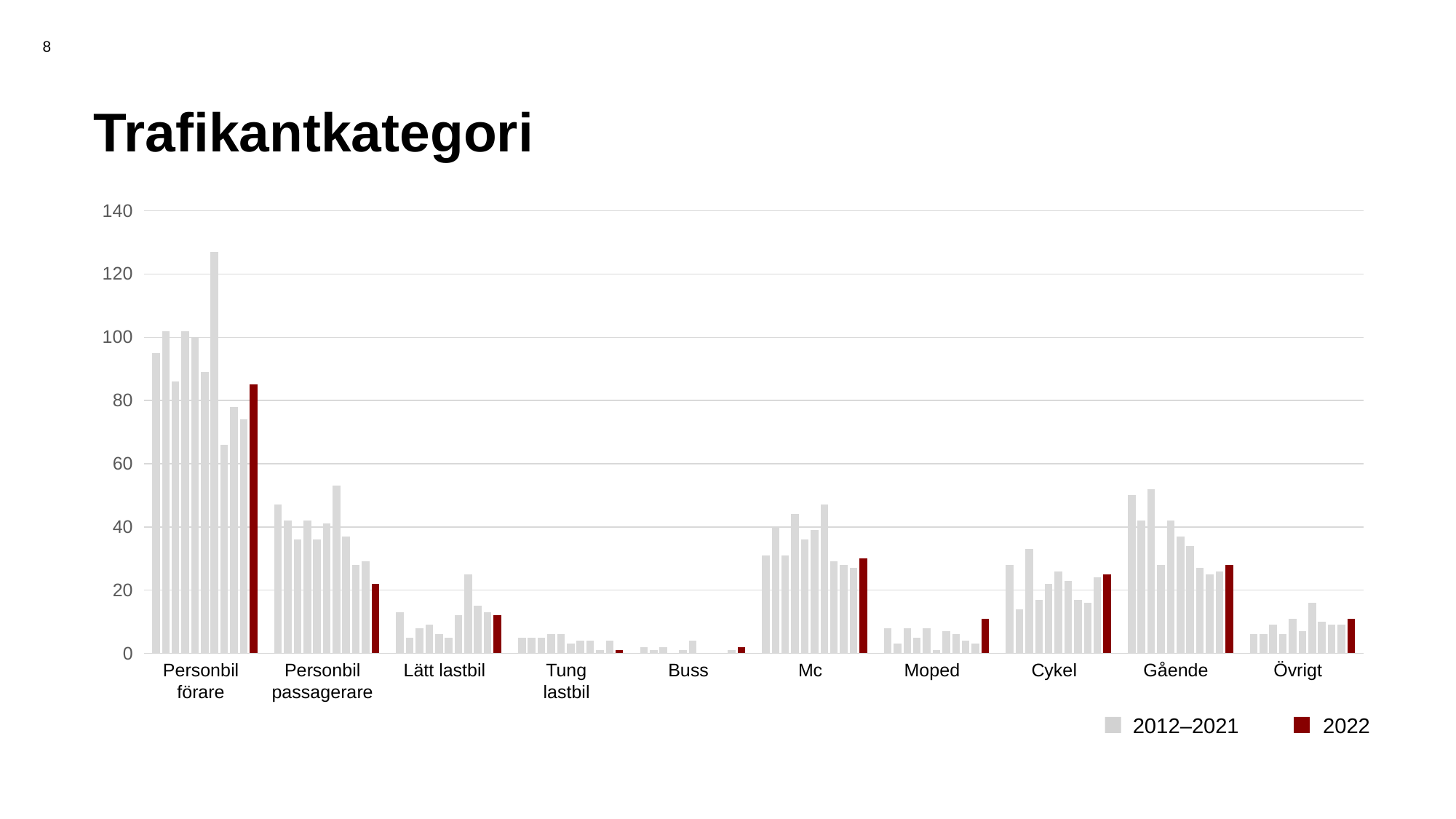
What is the title of the chart? Trafikantkategori Is the 2022 value for Mc greater or less than 20? greater Is the 2022 value for Gående greater or less than 40? less Which is larger in 2022, Personbil förare or Personbil passagerare? Personbil förare Is the 2022 value for Personbil passagerare greater or less than 40? less How many trafikant categories are shown on the x axis? 10 Which is larger in 2022, Mc or Moped? Mc Which series is shown in dark red? 2022 What kind of chart is shown on the slide? bar chart How many series does the legend list? 2 Which category has the highest 2022 bar? Personbil förare